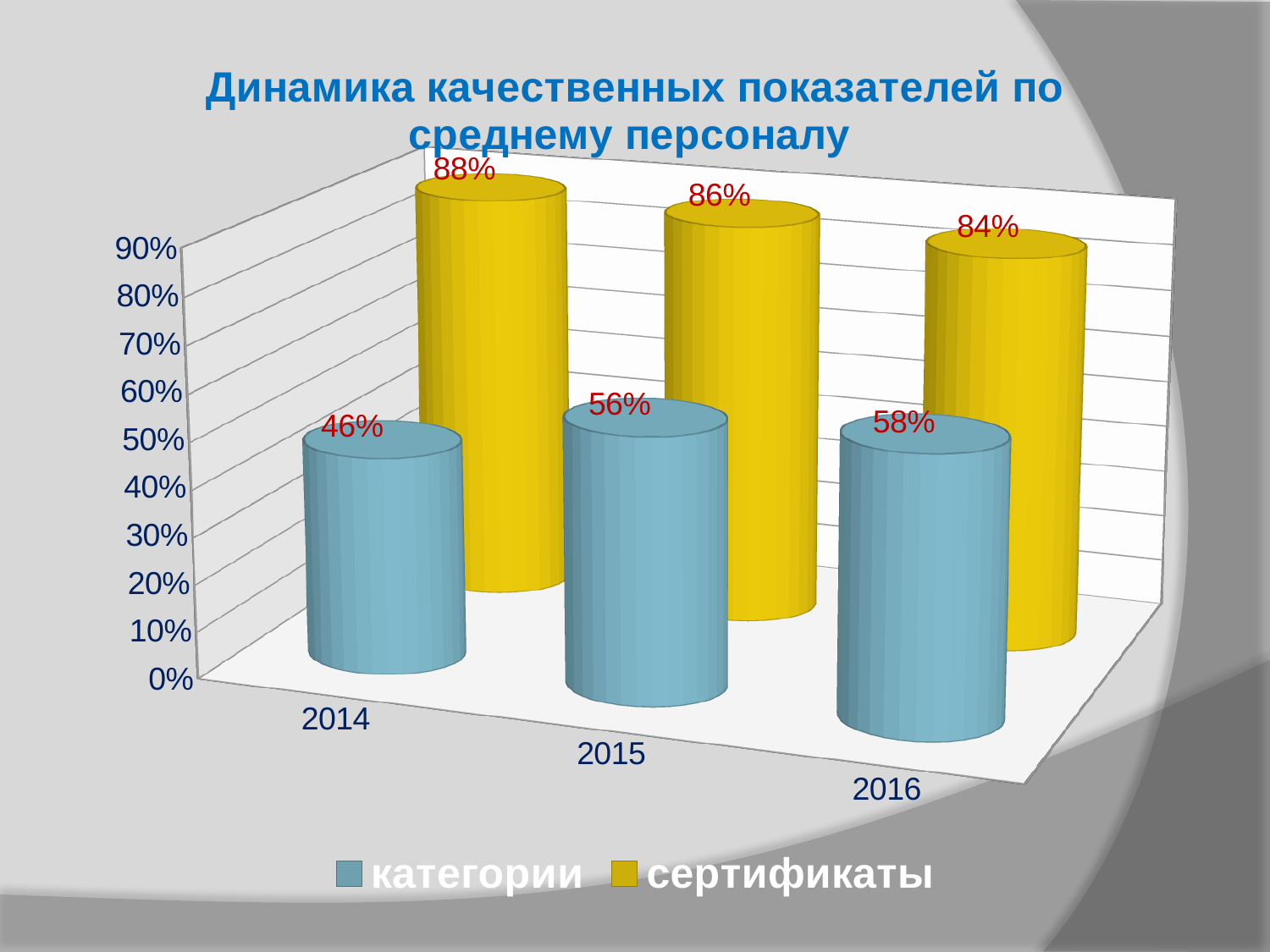
What is the value for сертификаты in 2016? 84% What is the difference between сертификаты and категории in 2016? 26% Which year has the lowest value for категории? 2014 Which is larger in 2015: категории or сертификаты? сертификаты What is the value for категории in 2015? 56% What is the value for категории in 2014? 46% Do the values for сертификаты rise or fall from 2014 to 2016? fall Which year has the highest value for сертификаты? 2014 What kind of chart is shown on the slide? bar chart What colour are the bars for сертификаты? yellow How many series does the legend list? 2 How many years are shown on the x axis? 3